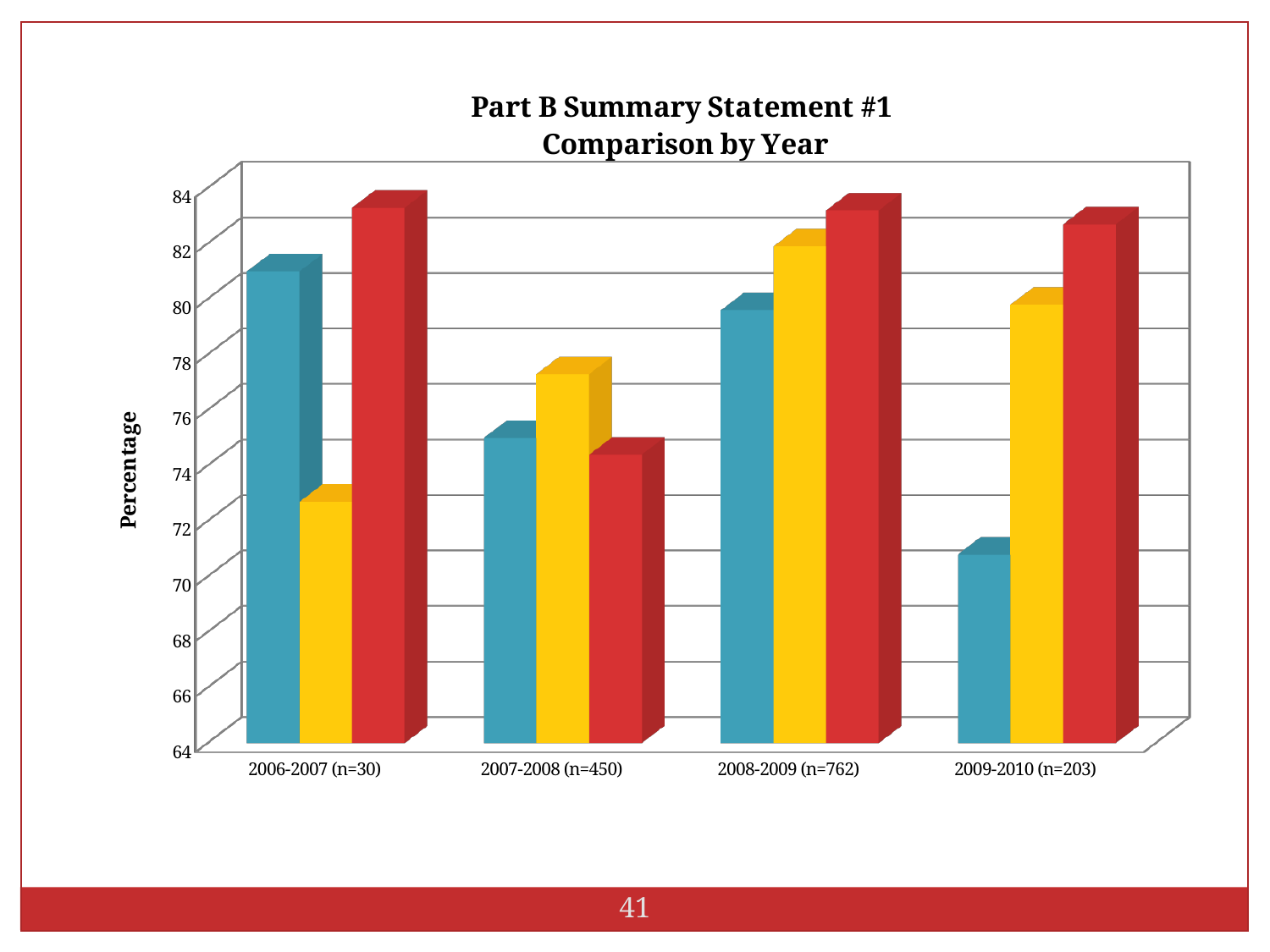
Is the value of the yellow bar for 2006-2007 (n=30) greater or less than 74? less What is the title of the chart? Part B Summary Statement #1 Comparison by Year Is the value of the yellow bar for 2009-2010 (n=203) greater or less than 78? greater For 2009-2010 (n=203), which is larger: the red bar or the blue bar? the red bar Is the value of the blue bar for 2009-2010 (n=203) greater or less than 72? less How many year categories are shown on the x axis? 4 Among the blue bars, which year has the lowest value? 2009-2010 (n=203) What type of chart is shown on the slide? bar chart What is the label on the vertical axis? Percentage How many bars are plotted for each year category? 3 For 2007-2008 (n=450), which is larger: the blue bar or the yellow bar? the yellow bar